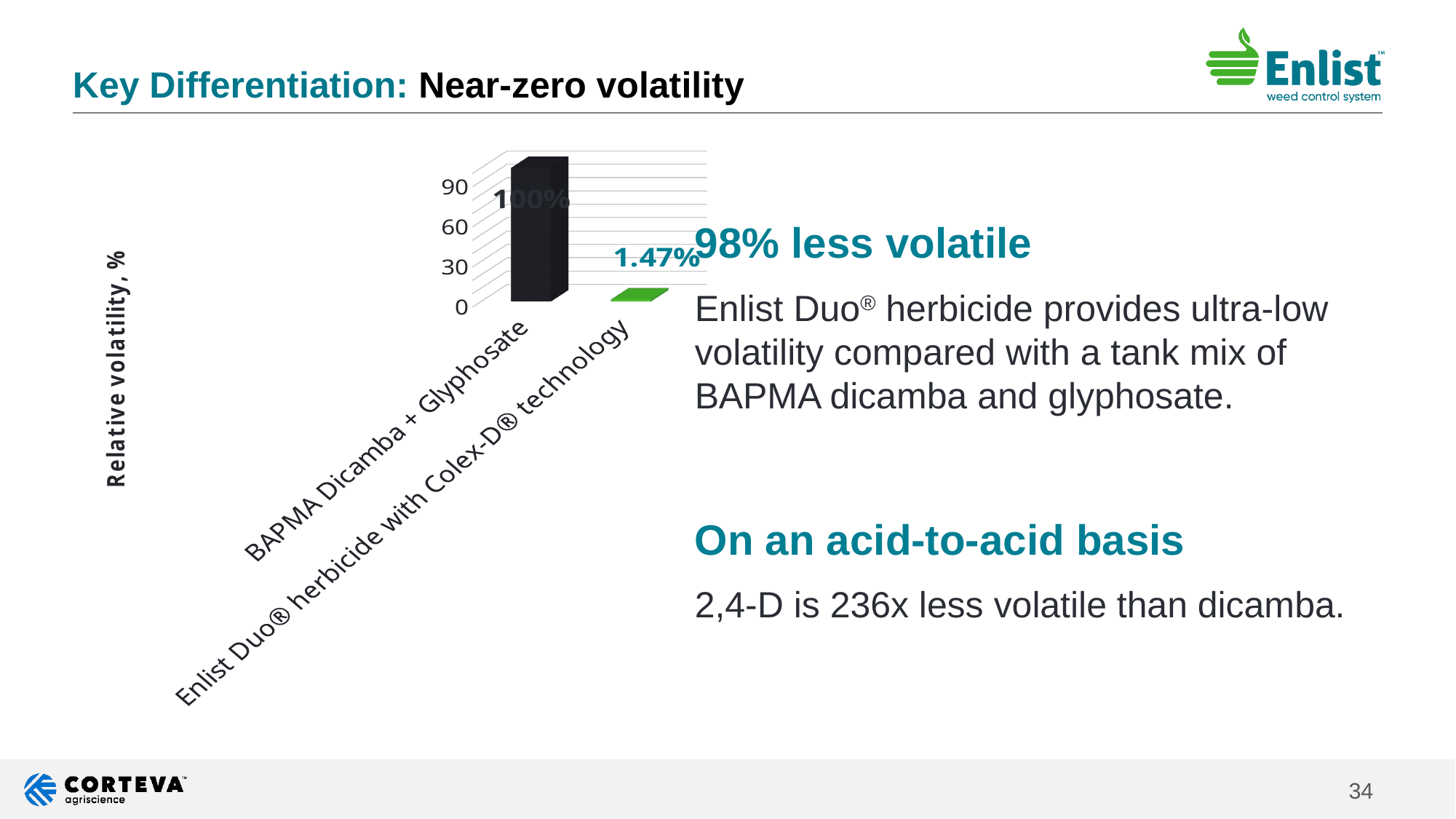
Do the values fall or rise from the first category to the second along the x axis? Fall Is the relative volatility for Enlist Duo® herbicide with Colex-D® technology greater or less than 30? less Which category has the highest relative volatility? BAPMA Dicamba + Glyphosate How many categories are plotted in the chart? 2 What is the relative volatility value shown for Enlist Duo® herbicide with Colex-D® technology? 1.47% What colour is the bar for Enlist Duo® herbicide with Colex-D® technology? Green Is the relative volatility for BAPMA Dicamba + Glyphosate greater or less than 90? greater What is the label of the vertical axis of the chart? Relative volatility, % Which has a larger relative volatility, BAPMA Dicamba + Glyphosate or Enlist Duo® herbicide with Colex-D® technology? BAPMA Dicamba + Glyphosate What kind of chart is shown on the slide? Bar chart Which category has the lowest relative volatility? Enlist Duo® herbicide with Colex-D® technology